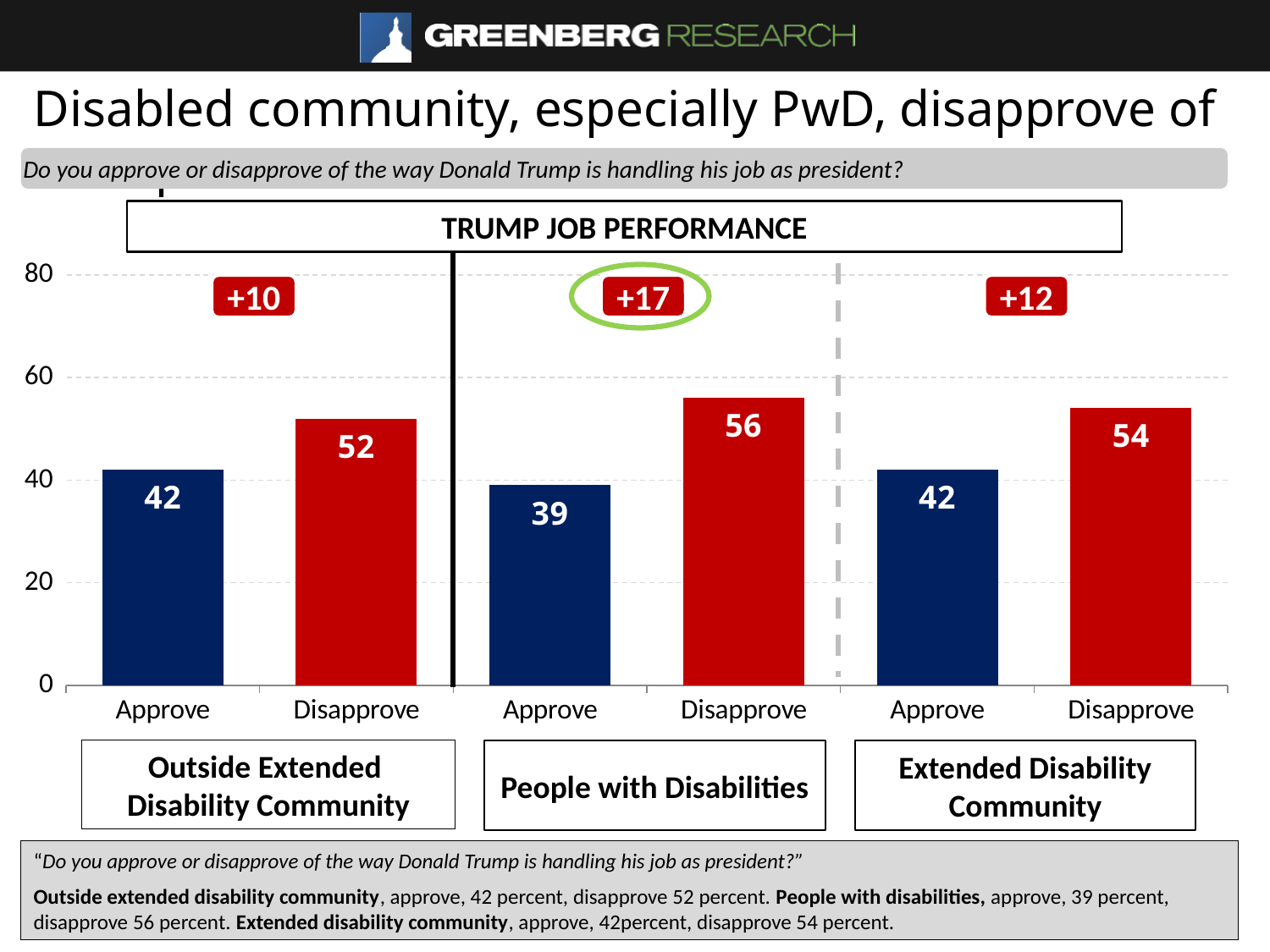
What is the title shown above the chart? TRUMP JOB PERFORMANCE What is the Disapprove value for the Outside Extended Disability Community group? 52 Which is larger for the Outside Extended Disability Community group, Approve or Disapprove? Disapprove What kind of chart is shown on the slide? bar chart What is the Disapprove value for the Extended Disability Community? 54 Is the Disapprove value for People with Disabilities greater or less than 60? less What is the Approve value for People with Disabilities? 39 Which bar has the highest value on the chart? Disapprove, People with Disabilities Which bar has the lowest value on the chart? Approve, People with Disabilities What is the difference between Disapprove and Approve for People with Disabilities? 17 What is the difference between Disapprove and Approve for the Extended Disability Community? 12 How many bars are plotted on the chart? 6